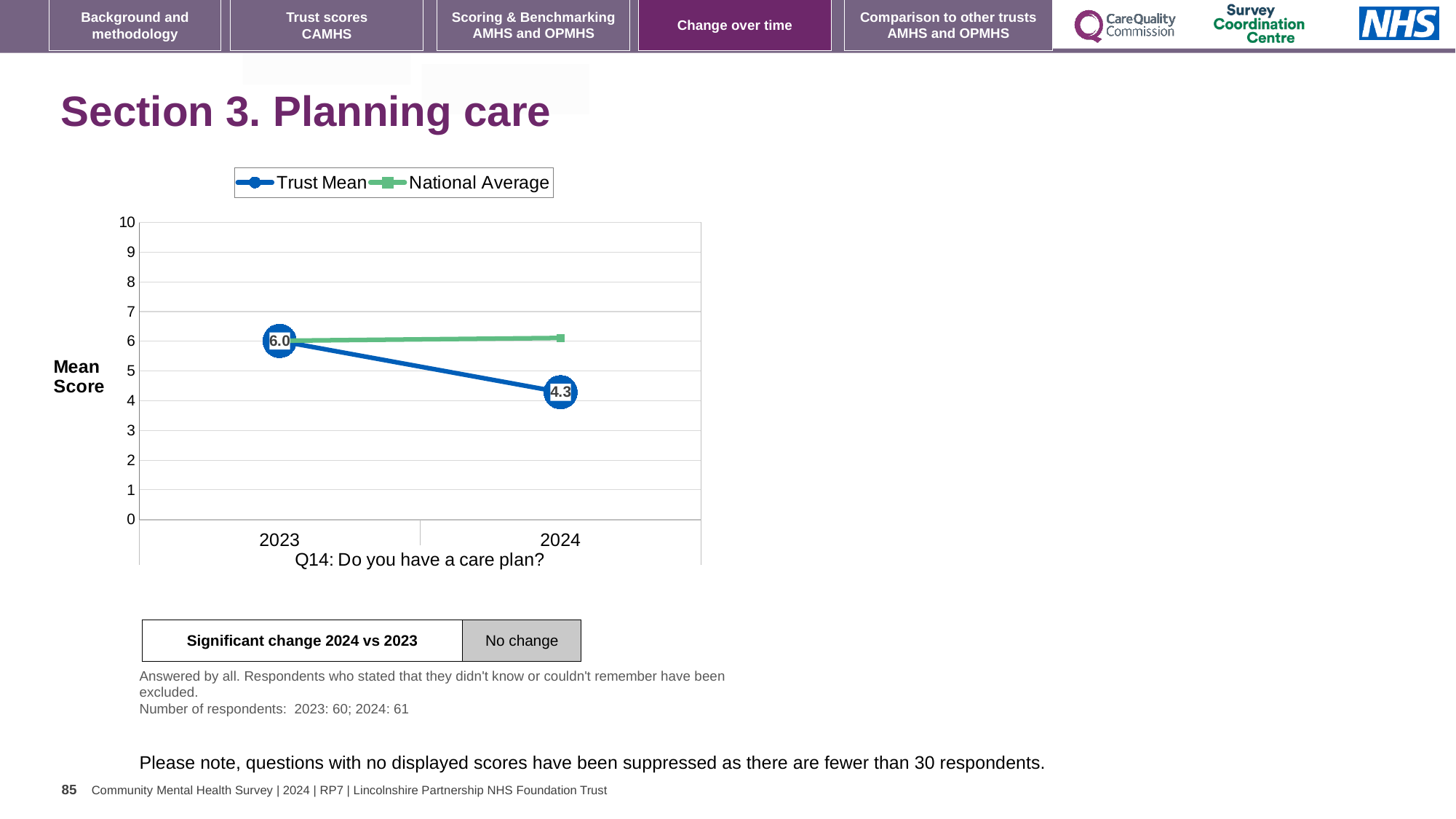
Does the Trust Mean rise or fall from 2023 to 2024? fall What is the Trust Mean score for 2024? 4.3 Is the National Average for 2024 greater or less than 5? greater How many series does the legend list? 2 What kind of chart is shown on the slide? line chart Which year has the lower Trust Mean score? 2024 What is the Trust Mean score for 2023? 6.0 Which year has the higher Trust Mean score? 2023 How many years are shown on the x axis? 2 What is the difference between the Trust Mean scores for 2023 and 2024? 1.7 In 2024, which is larger: the Trust Mean or the National Average? National Average Is the Trust Mean score for 2024 greater or less than 5? less